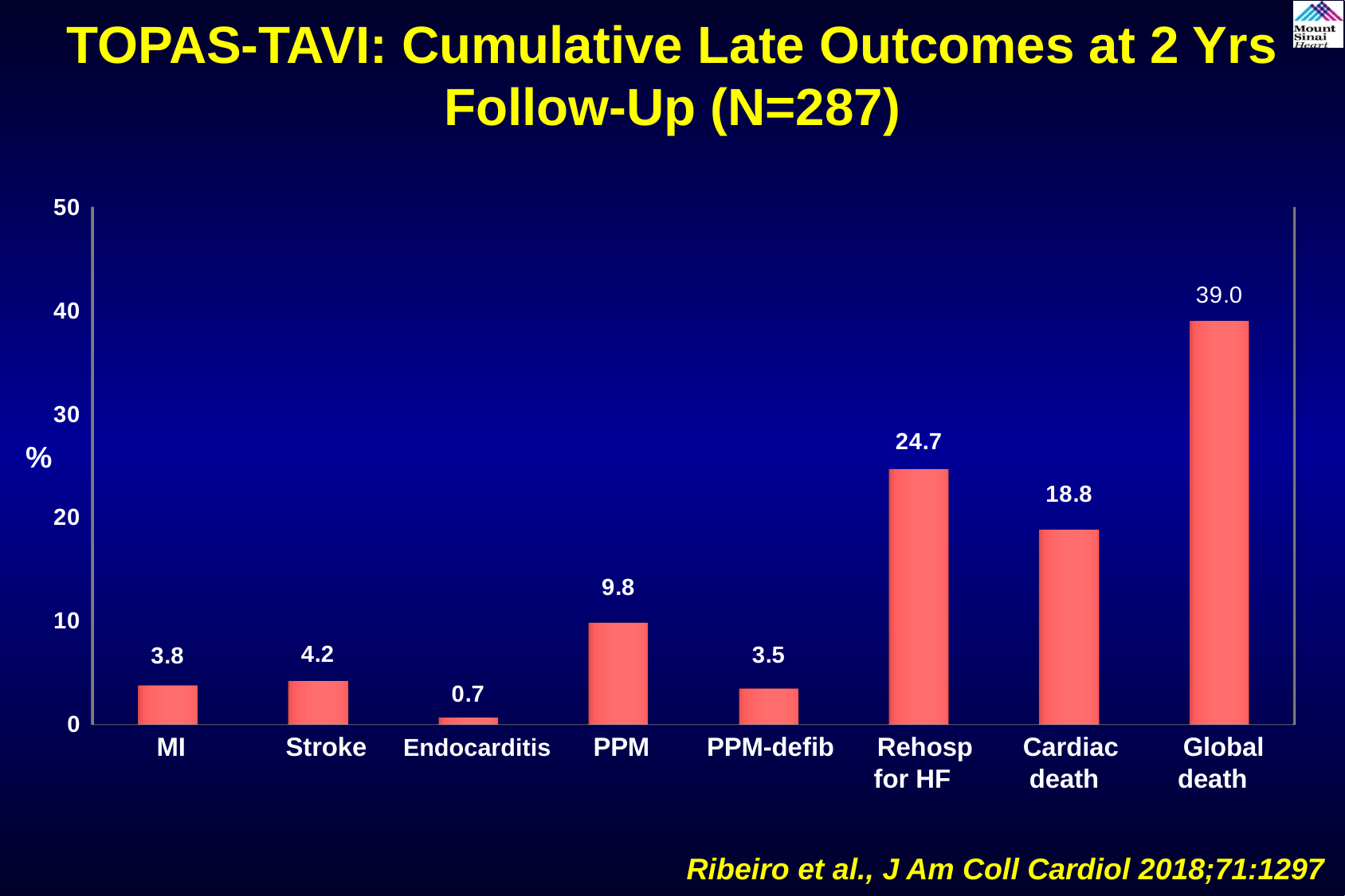
Which is larger, the value for MI or the value for Stroke? Stroke How many categories are shown on the x axis? 8 What kind of chart is shown on the slide? bar chart What is the value for Endocarditis? 0.7 What is the label on the y axis? % What is the value for Rehosp for HF? 24.7 Which category has the highest value? Global death Which category has the lowest value? Endocarditis What is the difference between the values for Global death and Cardiac death? 20.2 What is the value for Global death? 39.0 Is the value for Rehosp for HF greater or less than 20? greater What is the value for PPM? 9.8